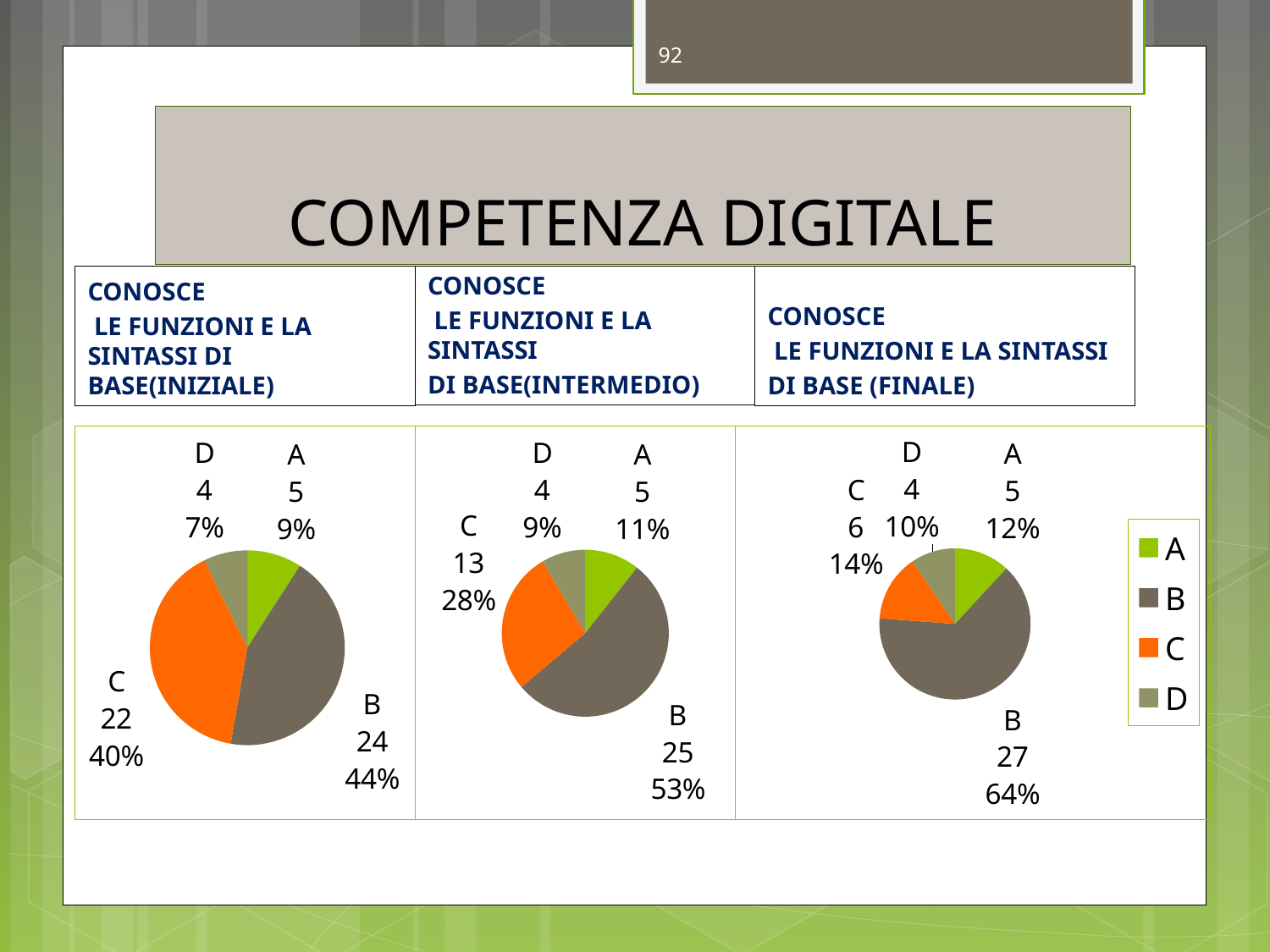
What type of chart is used on this slide? Pie chart In the middle pie chart (INTERMEDIO), what percentage share does category B have? 53% In the left pie chart (INIZIALE), what is the count for category B? 24 In the right pie chart (FINALE), what is the count for category B? 27 How many categories does each pie chart show? 4 In the left pie chart (INIZIALE), which category has the smallest share? D In the right pie chart (FINALE), which category has the largest share? B In the right pie chart (FINALE), what percentage share does category D have? 10% In the middle pie chart (INTERMEDIO), what is the count for category C? 13 In the middle pie chart (INTERMEDIO), what is the difference between the counts for B and C? 12 In the left pie chart (INIZIALE), which is larger, the count for B or the count for C? B In the left pie chart (INIZIALE), what percentage share does category C have? 40%